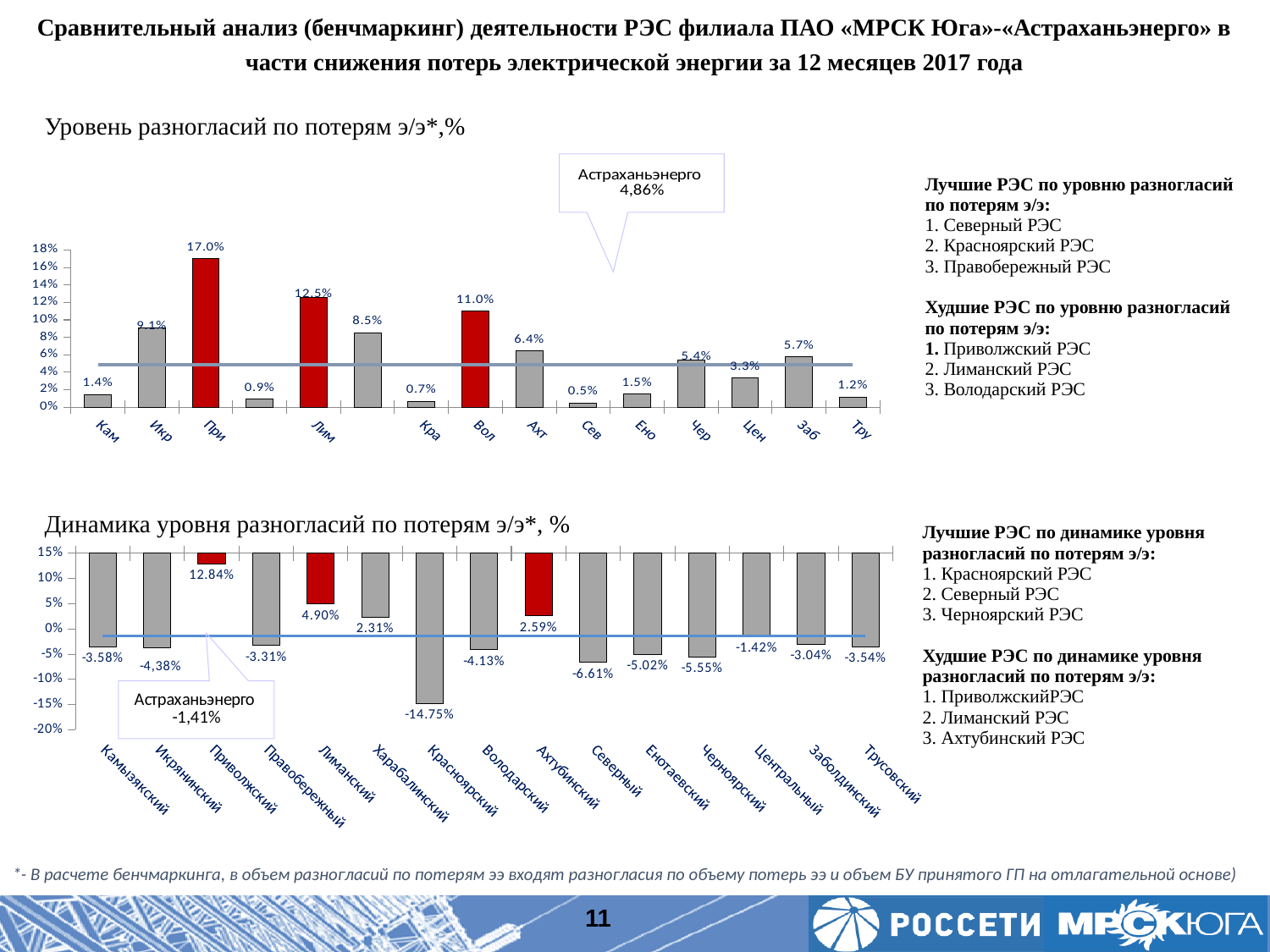
In the top chart "Уровень разногласий по потерям э/э*,%", how many bars are plotted? 15 In the bottom chart "Динамика уровня разногласий по потерям э/э*, %", which category has the highest value? Приволжский In the top chart "Уровень разногласий по потерям э/э*,%", what value is shown for Астраханьэнерго? 4,86% In the bottom chart "Динамика уровня разногласий по потерям э/э*, %", which is larger, the value for Северный or the value for Енотаевский? Енотаевский In the top chart "Уровень разногласий по потерям э/э*,%", which category has the lowest value? Сев In the top chart "Уровень разногласий по потерям э/э*,%", what is the value for При? 17.0% In the top chart "Уровень разногласий по потерям э/э*,%", what is the difference between the values for При and Лим? 4.5 percentage points What type of chart is the top chart "Уровень разногласий по потерям э/э*,%"? Bar chart In the bottom chart "Динамика уровня разногласий по потерям э/э*, %", what value is shown for Астраханьэнерго? -1,41% In the top chart "Уровень разногласий по потерям э/э*,%", which category has the highest value? При In the top chart "Уровень разногласий по потерям э/э*,%", which is larger, the value for Вол or the value for Ахт? Вол In the bottom chart "Динамика уровня разногласий по потерям э/э*, %", what is the value for Красноярский? -14.75%